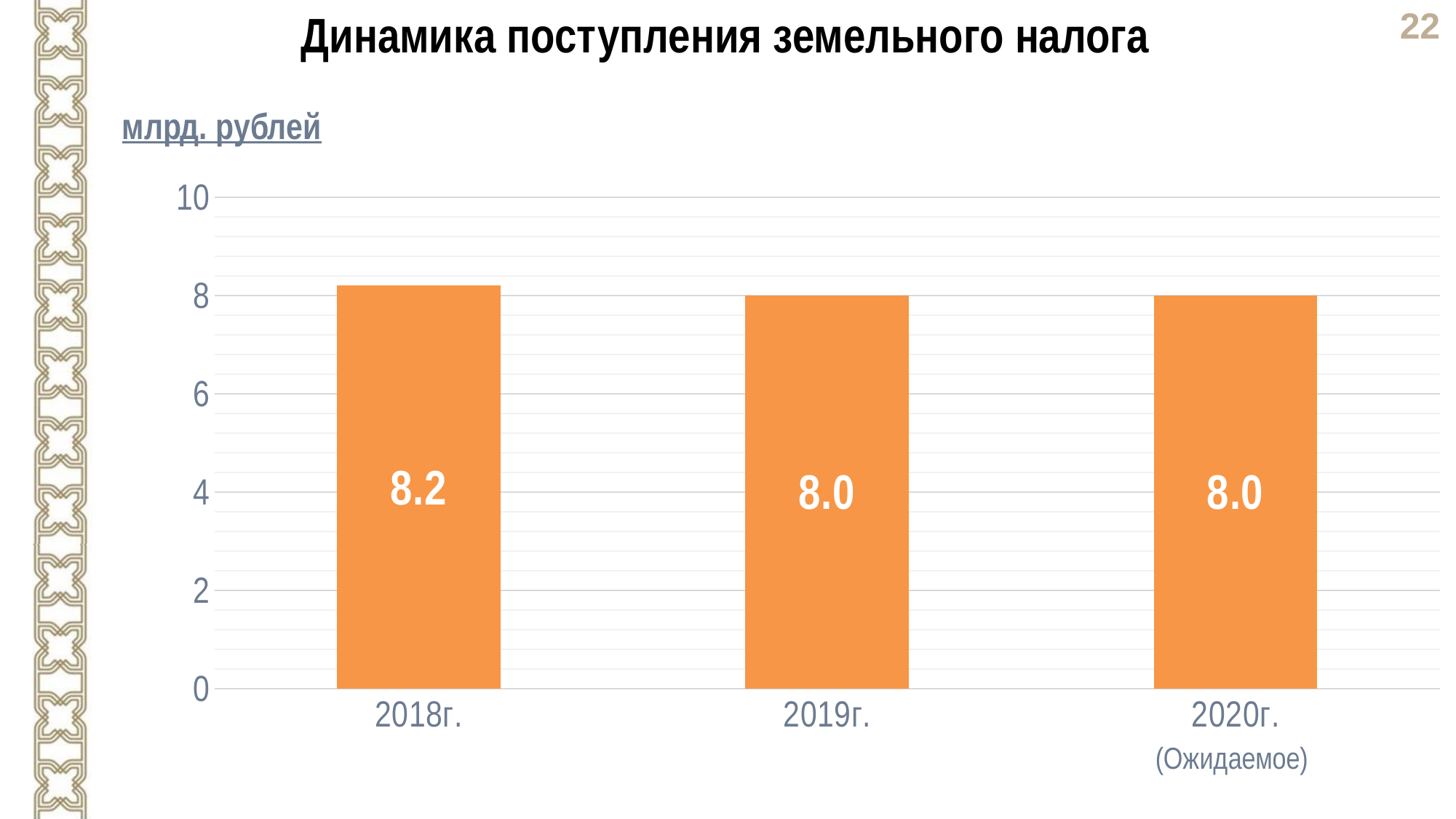
What is the value for 2018г.? 8.2 Which year has the highest value? 2018г. What kind of chart is shown on the slide? bar chart Do the values rise or fall from 2018г. to 2019г.? fall Is the value for 2019г. greater or less than 10? less What is the value for 2019г.? 8.0 Which is larger, the value for 2018г. or the value for 2019г.? 2018г. How many bars are shown in the chart? 3 What is the value for 2020г. (Ожидаемое)? 8.0 What is the title of the chart? Динамика поступления земельного налога Is the value for 2018г. greater or less than 8? greater What is the difference between the values for 2018г. and 2019г.? 0.2